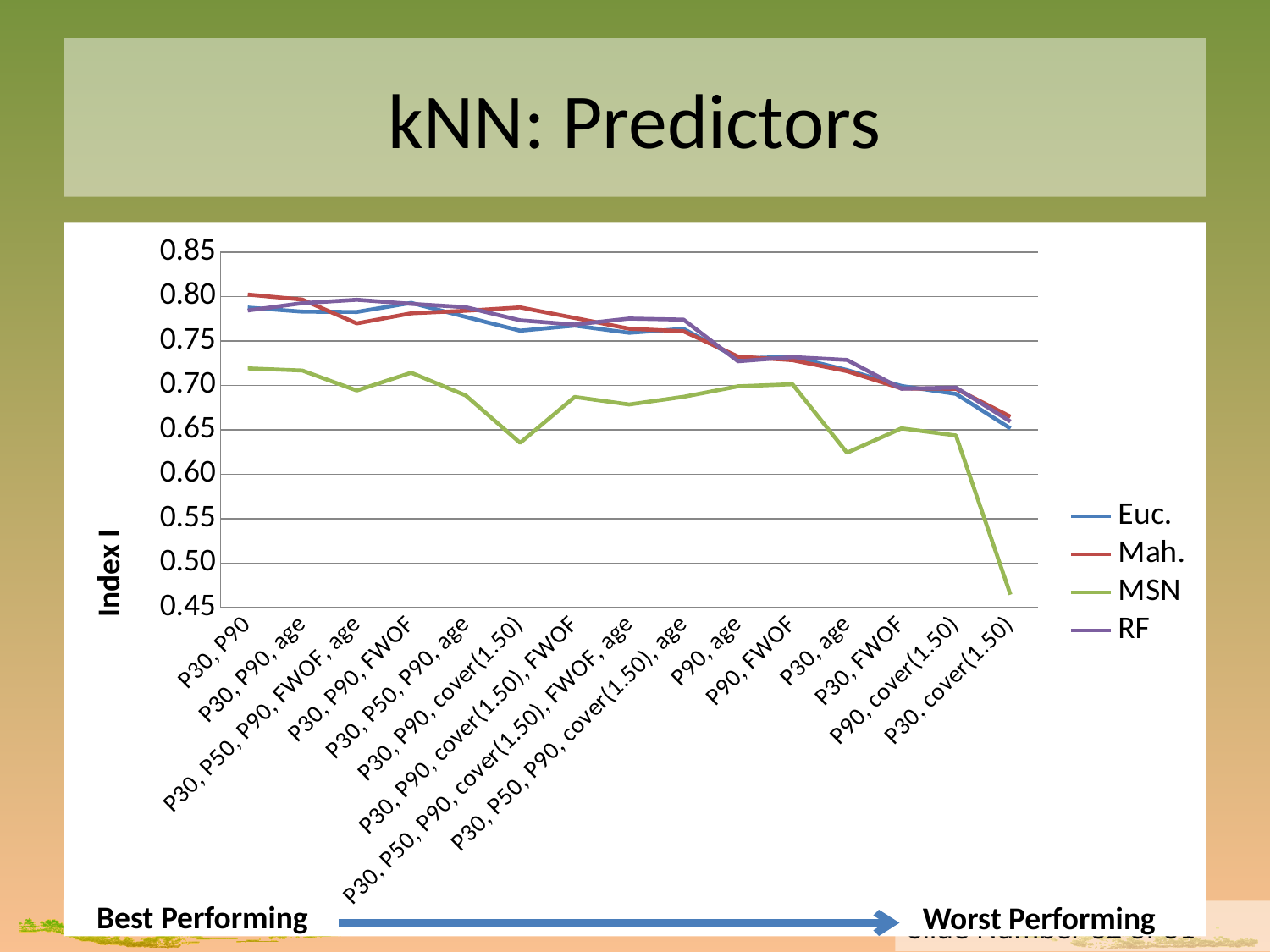
How many predictor categories are plotted along the x axis? 15 Is the MSN value for P30, cover(1.50) greater or less than 0.50? less At P30, P90, which series has the higher value, Mah. or MSN? Mah. Is the RF value for P30, cover(1.50) greater or less than 0.70? less How many series does the legend list? 4 At P30, P90, cover(1.50), which series has the higher value, Euc. or MSN? Euc. What is the title of the y axis? Index I For the MSN series, which category has the lowest value? P30, cover(1.50) Is the Euc. value for P30, P90 greater or less than 0.75? greater What kind of chart is shown on the slide? line chart Which series are listed in the legend? Euc., Mah., MSN, RF